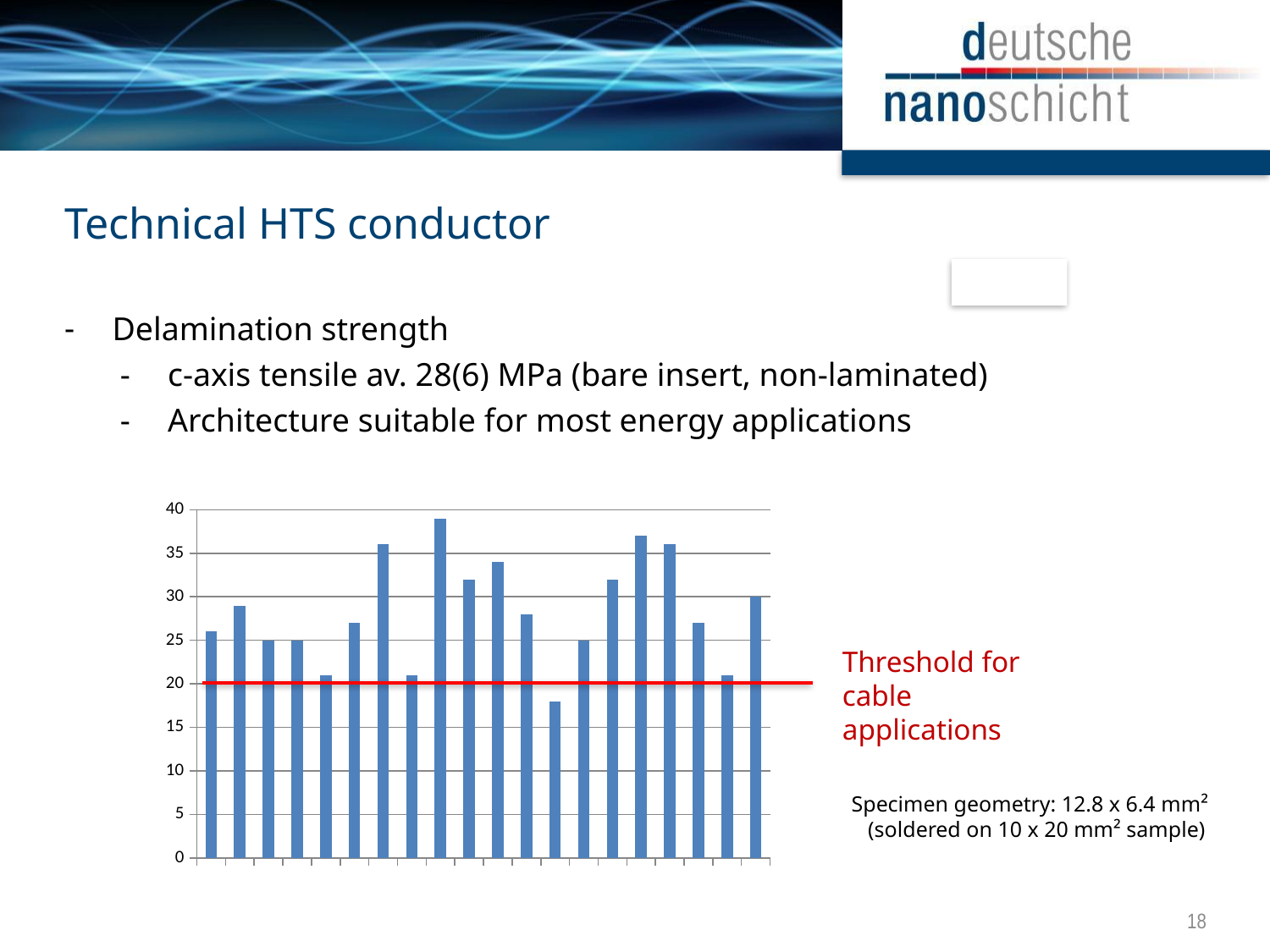
What is the highest value shown on the vertical axis of the chart? 40 What kind of chart is shown on the slide? bar chart How many bars in the chart fall below the red threshold line? 1 Which is taller, the leftmost bar or the rightmost bar in the chart? the rightmost bar Is the value of the shortest bar in the chart greater or less than 20? less Is the value of the rightmost bar in the chart greater or less than 25? greater Is the value of the second bar from the left greater or less than 25? greater How many bars are plotted in the chart? 20 What does the red horizontal line across the chart represent? Threshold for cable applications